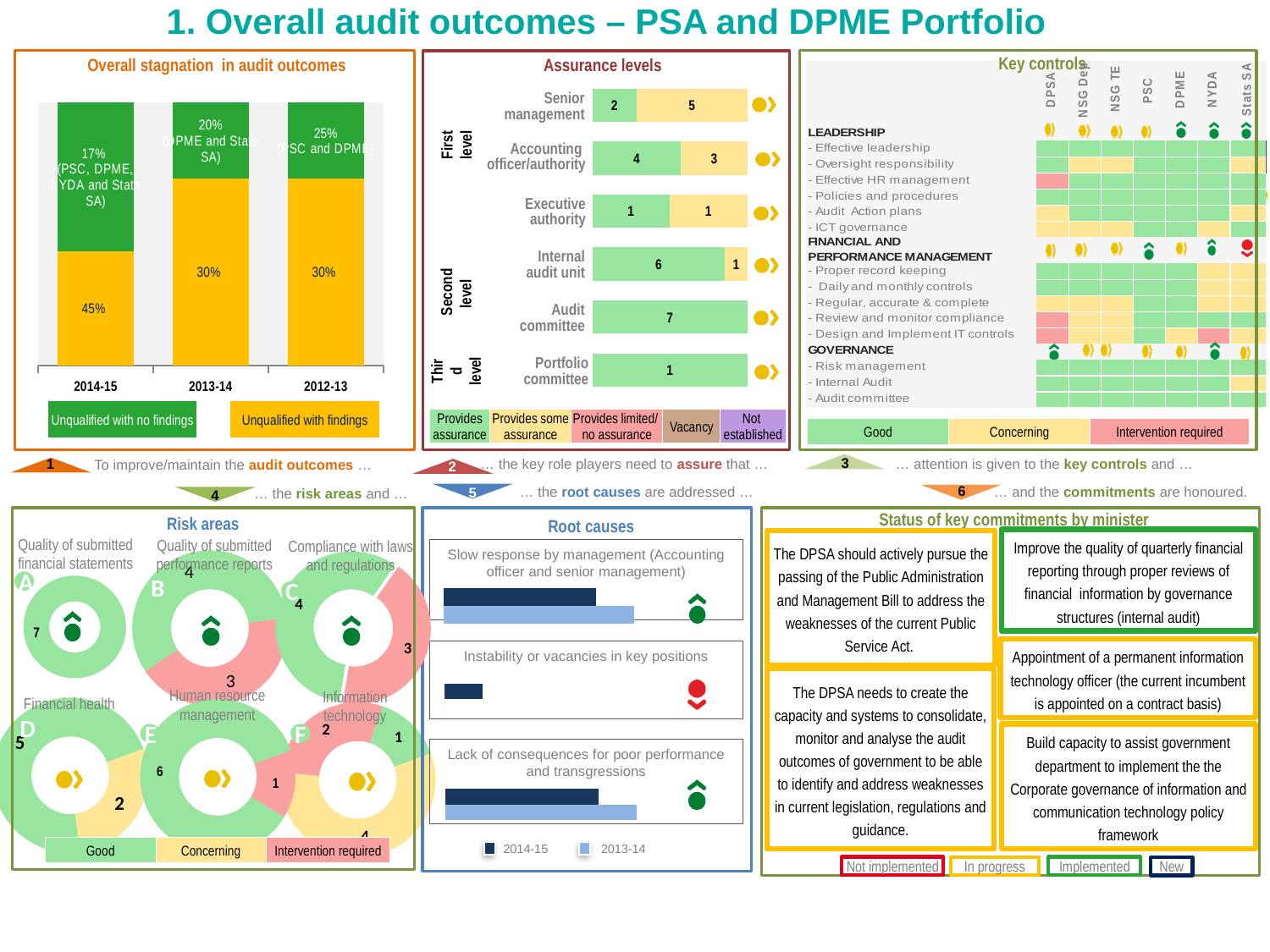
How many series does the legend of the 'Overall stagnation in audit outcomes' chart list? 2 In the 'Overall stagnation in audit outcomes' chart, what is the value for 'Unqualified with no findings' in 2012-13? 25% In the 'Root causes' chart, for 'Slow response by management', which series has the longer bar, 2014-15 or 2013-14? 2013-14 In the 'Assurance levels' chart, which role has the highest 'Provides assurance' value? Audit committee What kind of chart is the 'Overall stagnation in audit outcomes' chart? Bar chart In the 'Assurance levels' chart, what is the total of the stacked bar for Senior management? 7 In the 'Overall stagnation in audit outcomes' chart, what is the difference between the 'Unqualified with findings' values for 2014-15 and 2013-14? 15% In the 'Overall stagnation in audit outcomes' chart, what is the value for 'Unqualified with findings' in 2014-15? 45% In the 'Assurance levels' chart, what is the 'Provides some assurance' value for Senior management? 5 In the 'Assurance levels' chart, what is the 'Provides assurance' value for the Audit committee? 7 How many entries does the legend of the 'Assurance levels' chart list? 5 In the 'Overall stagnation in audit outcomes' chart, what is the value for 'Unqualified with no findings' in 2013-14? 20%